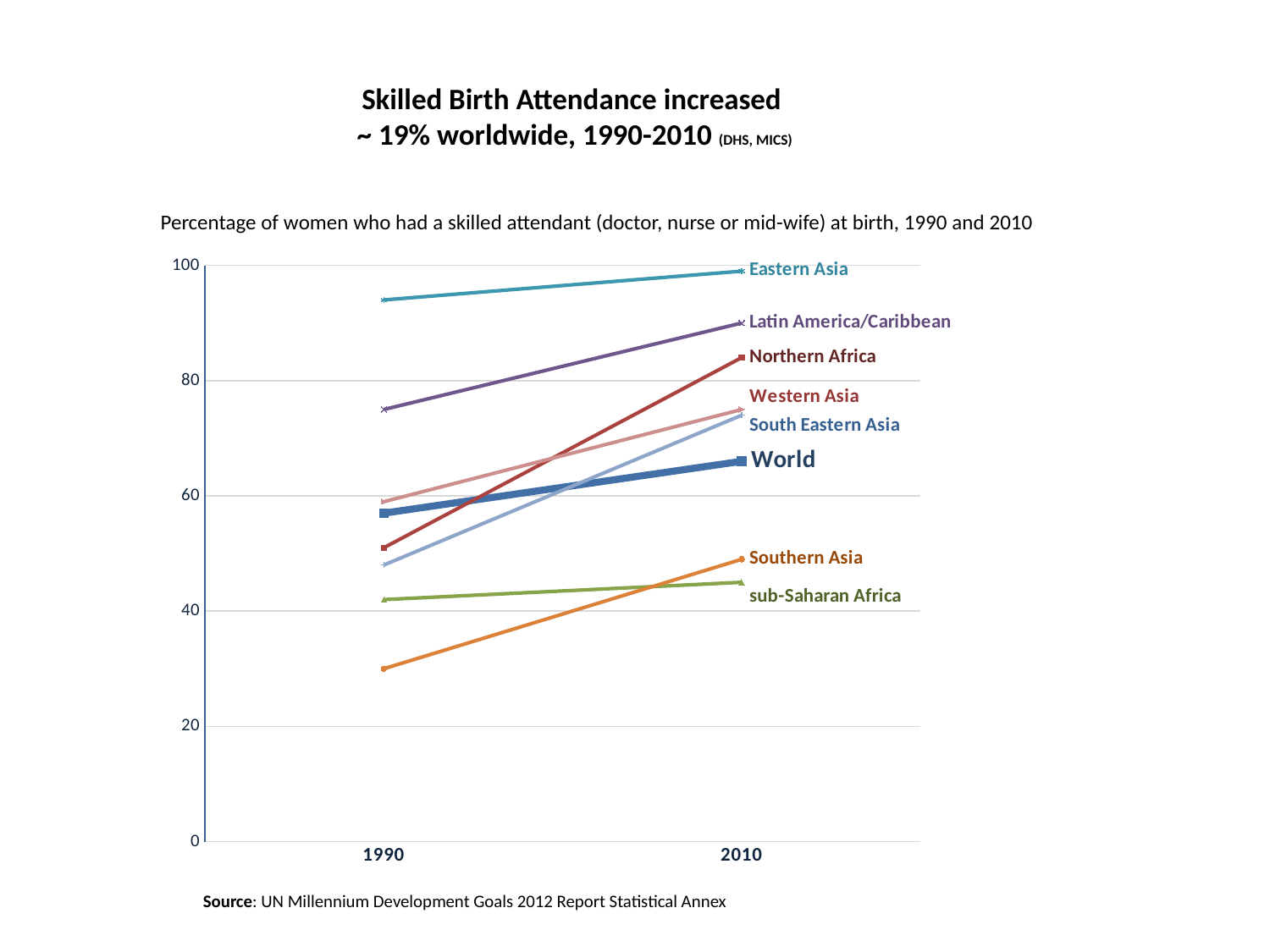
What kind of chart is shown on the slide? line chart Which region has the lowest skilled birth attendance in 2010? sub-Saharan Africa How many regional series (lines) are labelled on the chart? 8 Is the value for Eastern Asia in 1990 greater or less than 80? greater Which region has the highest skilled birth attendance in 2010? Eastern Asia Is the value for Southern Asia in 1990 greater or less than 40? less Which region has the lowest skilled birth attendance in 1990? Southern Asia Does the World line rise or fall from 1990 to 2010? rise Which region's line shows the steepest increase from 1990 to 2010? Northern Africa In 1990, which is higher: Southern Asia or sub-Saharan Africa? sub-Saharan Africa In 2010, which is higher: Northern Africa or Western Asia? Northern Africa How many years are shown on the x axis of the chart? 2